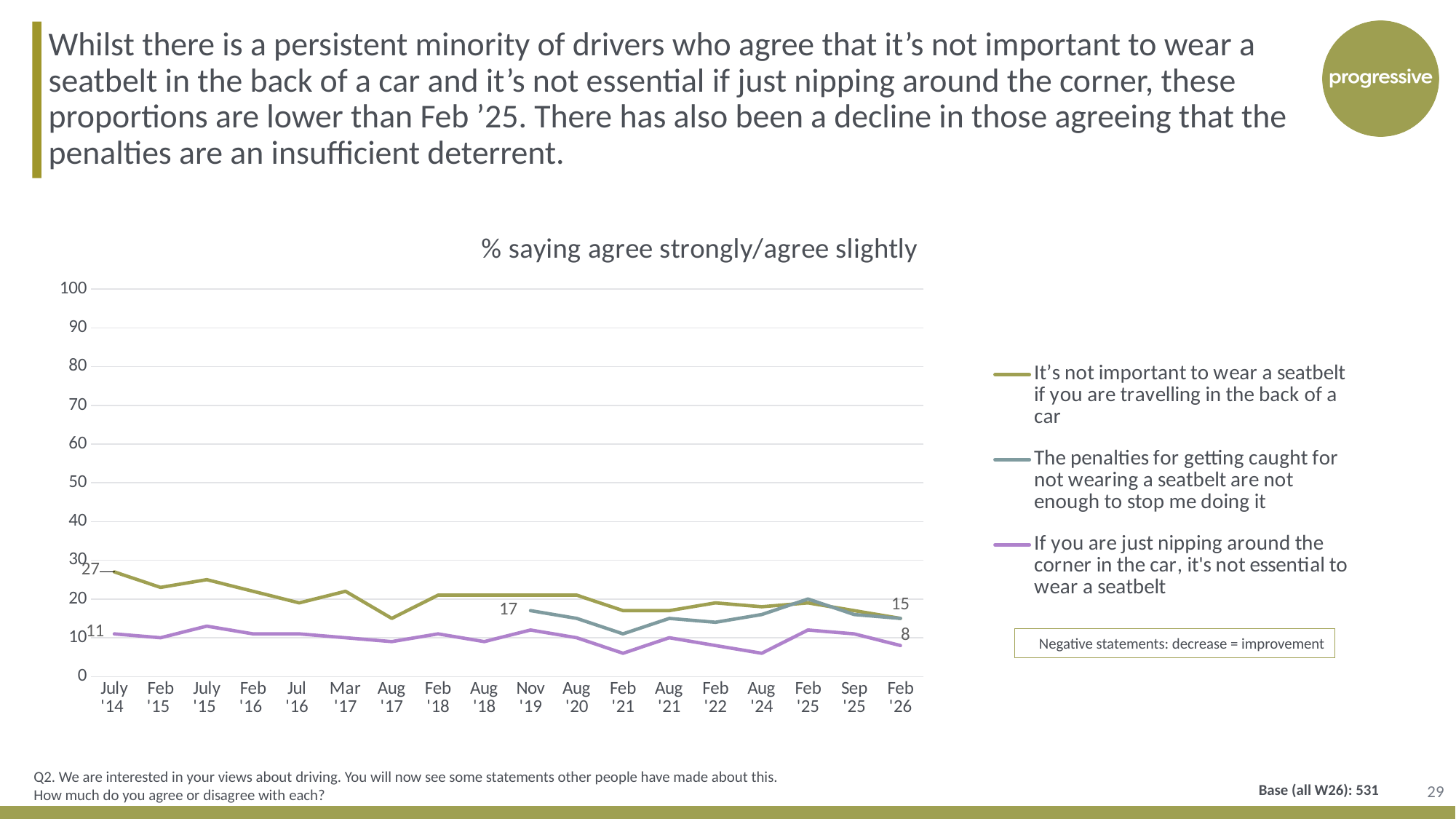
What is the title of the chart? % saying agree strongly/agree slightly What is the value for 'It's not important to wear a seatbelt if you are travelling in the back of a car' in Feb '26? 15 How many series does the legend list? 3 How many time points are shown along the x axis? 18 What is the value for 'If you are just nipping around the corner in the car, it's not essential to wear a seatbelt' in July '14? 11 What kind of chart is shown on the slide? line chart Is the value for 'If you are just nipping around the corner in the car, it's not essential to wear a seatbelt' in Feb '21 greater or less than 10? less What is the value for 'It's not important to wear a seatbelt if you are travelling in the back of a car' in July '14? 27 By how much did 'It's not important to wear a seatbelt if you are travelling in the back of a car' fall between July '14 and Feb '26? 12 What is the value for 'The penalties for getting caught for not wearing a seatbelt are not enough to stop me doing it' in Nov '19? 17 What is the value for 'If you are just nipping around the corner in the car, it's not essential to wear a seatbelt' in Feb '26? 8 In July '14, which is larger: the value for 'It's not important to wear a seatbelt if you are travelling in the back of a car' or the value for 'If you are just nipping around the corner in the car, it's not essential to wear a seatbelt'? It's not important to wear a seatbelt if you are travelling in the back of a car